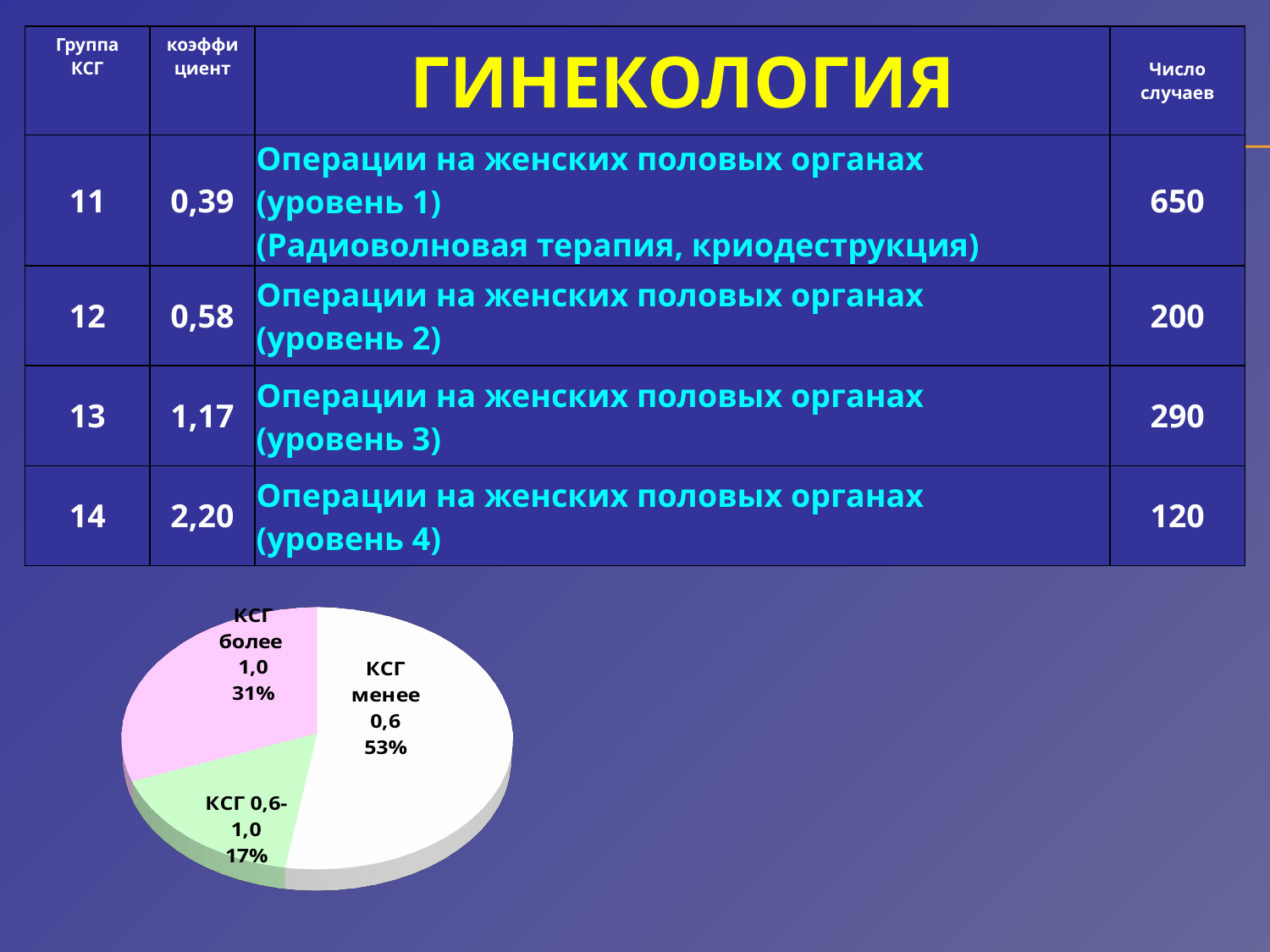
Which slice of the pie chart is the smallest? КСГ 0,6-1,0 What is the difference in percentage points between the "КСГ менее 0,6" slice and the "КСГ более 1,0" slice? 22 Which is larger in the pie chart: the "КСГ более 1,0" slice or the "КСГ 0,6-1,0" slice? КСГ более 1,0 What colour is the "КСГ более 1,0" slice in the pie chart? pink What is the difference in percentage points between the "КСГ более 1,0" slice and the "КСГ 0,6-1,0" slice? 14 What kind of chart is shown at the bottom of the slide? pie chart What colour is the "КСГ 0,6-1,0" slice in the pie chart? light green How many slices does the pie chart have? 3 Which slice of the pie chart is the largest? КСГ менее 0,6 What share of the pie does the slice "КСГ менее 0,6" represent? 53% What share of the pie does the slice "КСГ более 1,0" represent? 31% What share of the pie does the slice "КСГ 0,6-1,0" represent? 17%